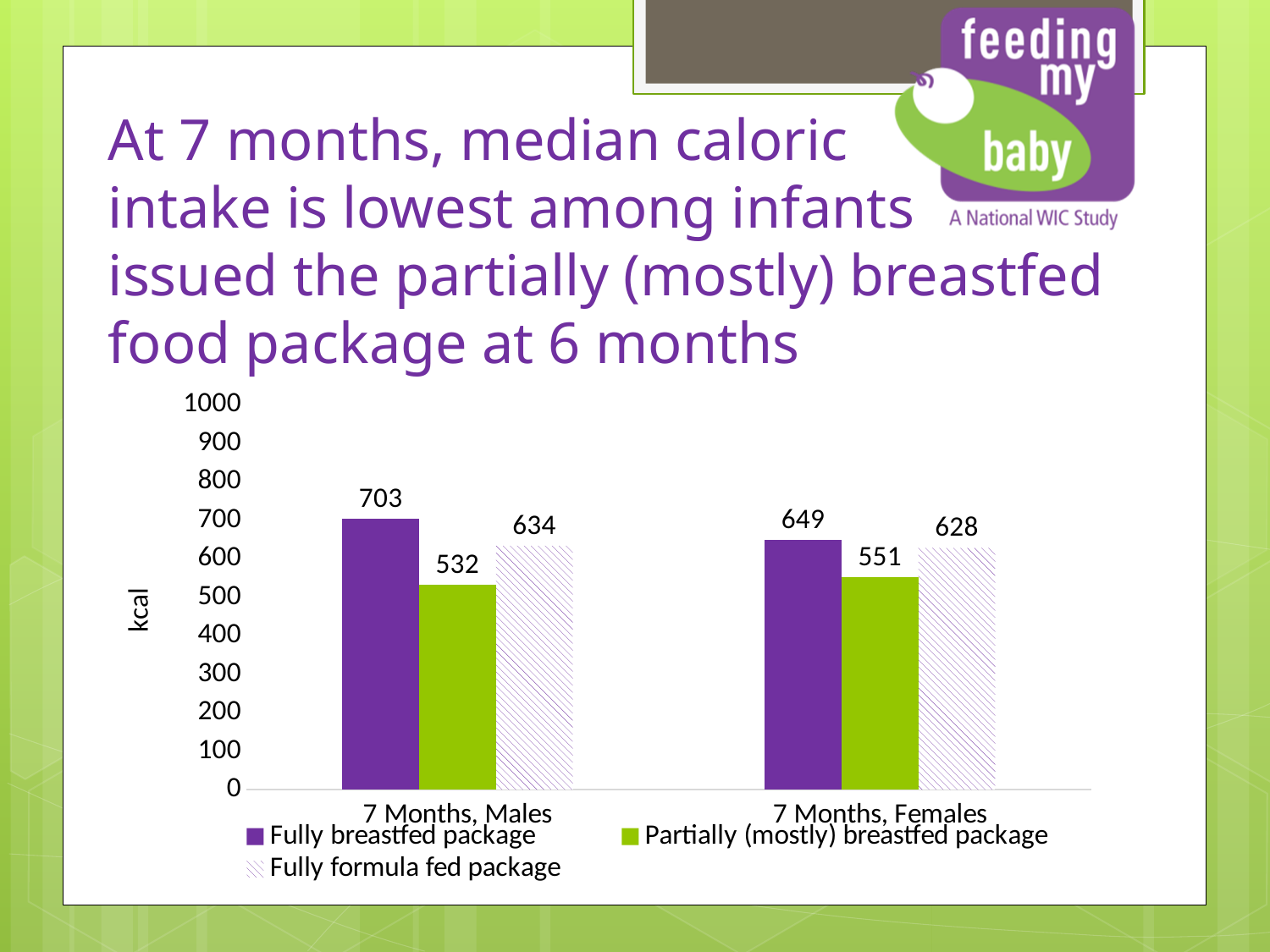
Which is larger: the Fully breastfed package value for 7 Months, Males or for 7 Months, Females? 7 Months, Males Which food package has the highest value among 7 Months, Females? Fully breastfed package What kind of chart is shown on the slide? bar chart What is the value for the Fully formula fed package among 7 Months, Males? 634 What is the label on the vertical axis of the chart? kcal What is the median caloric intake for the Fully breastfed package among 7 Months, Males? 703 Is the value for the Partially (mostly) breastfed package among 7 Months, Females greater or less than 600? less What is the difference between the Fully breastfed package and the Partially (mostly) breastfed package values for 7 Months, Males? 171 How many series does the legend list? 3 What is the value for the Partially (mostly) breastfed package among 7 Months, Females? 551 Which food package has the lowest value among 7 Months, Males? Partially (mostly) breastfed package What is the difference between the Fully formula fed package values for 7 Months, Males and 7 Months, Females? 6